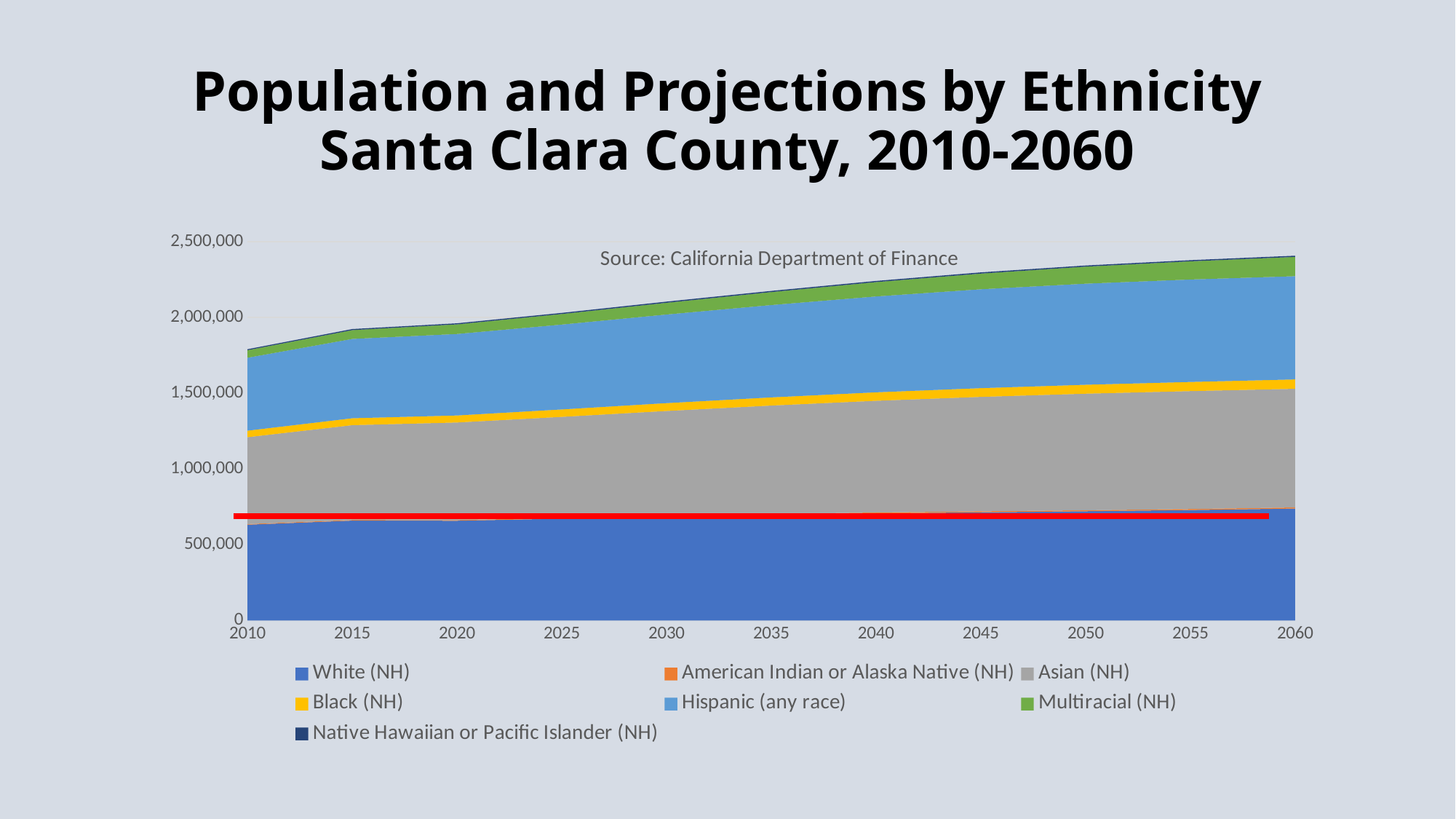
Is the total population in 2060 greater or less than 2,000,000? greater Is the total population in 2010 greater or less than 2,000,000? less What kind of chart is shown on the slide? Stacked area chart Is the total population in 2060 greater or less than 2,500,000? less In 2060, which is larger, the Black (NH) band or the American Indian or Alaska Native (NH) band? Black (NH) What source is cited on the chart? California Department of Finance How many series does the legend list? 7 Which year has the larger total population, 2010 or 2060? 2060 Which colour represents Hispanic (any race) in the legend? Light blue How many year labels are shown along the x axis? 11 Does the total population rise or fall from 2010 to 2060? Rises